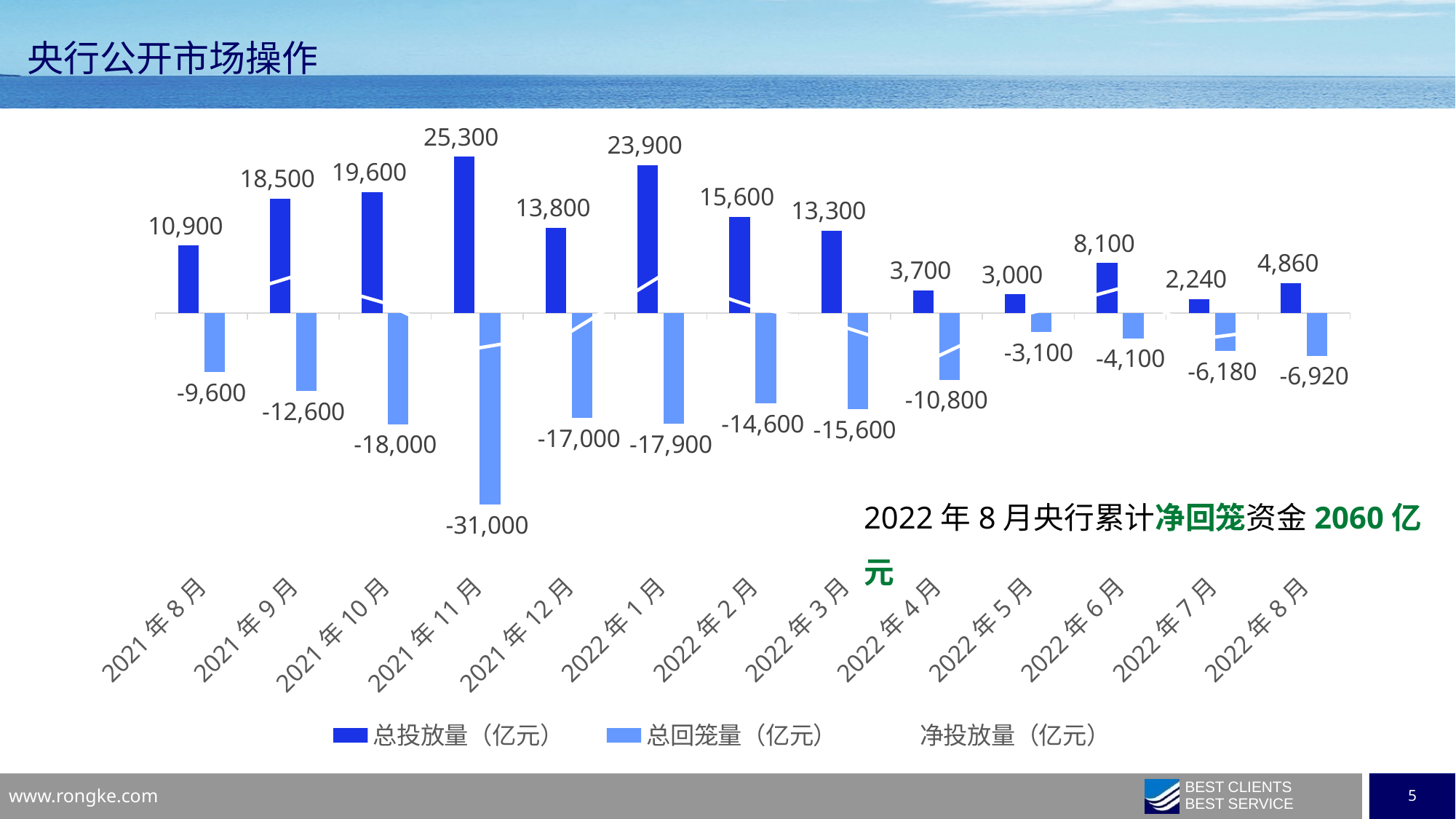
What kind of chart is shown on the slide? Bar chart What is the difference between the 总投放量 for 2022年1月 and 2022年2月? 8,300 What is the 总投放量 value for 2022年7月? 2,240 Which month has the highest 总投放量? 2021年11月 Which is larger, the 总投放量 for 2021年9月 or for 2021年10月? 2021年10月 Which month has the lowest 总投放量? 2022年7月 How many months are shown on the x axis? 13 How many series does the legend list? 3 What is the 总回笼量 value for 2022年8月? -6,920 What is the 总投放量 value for 2021年11月? 25,300 Which month has the largest 总回笼量 in magnitude (the most negative value)? 2021年11月 What is the title of the slide containing the chart? 央行公开市场操作